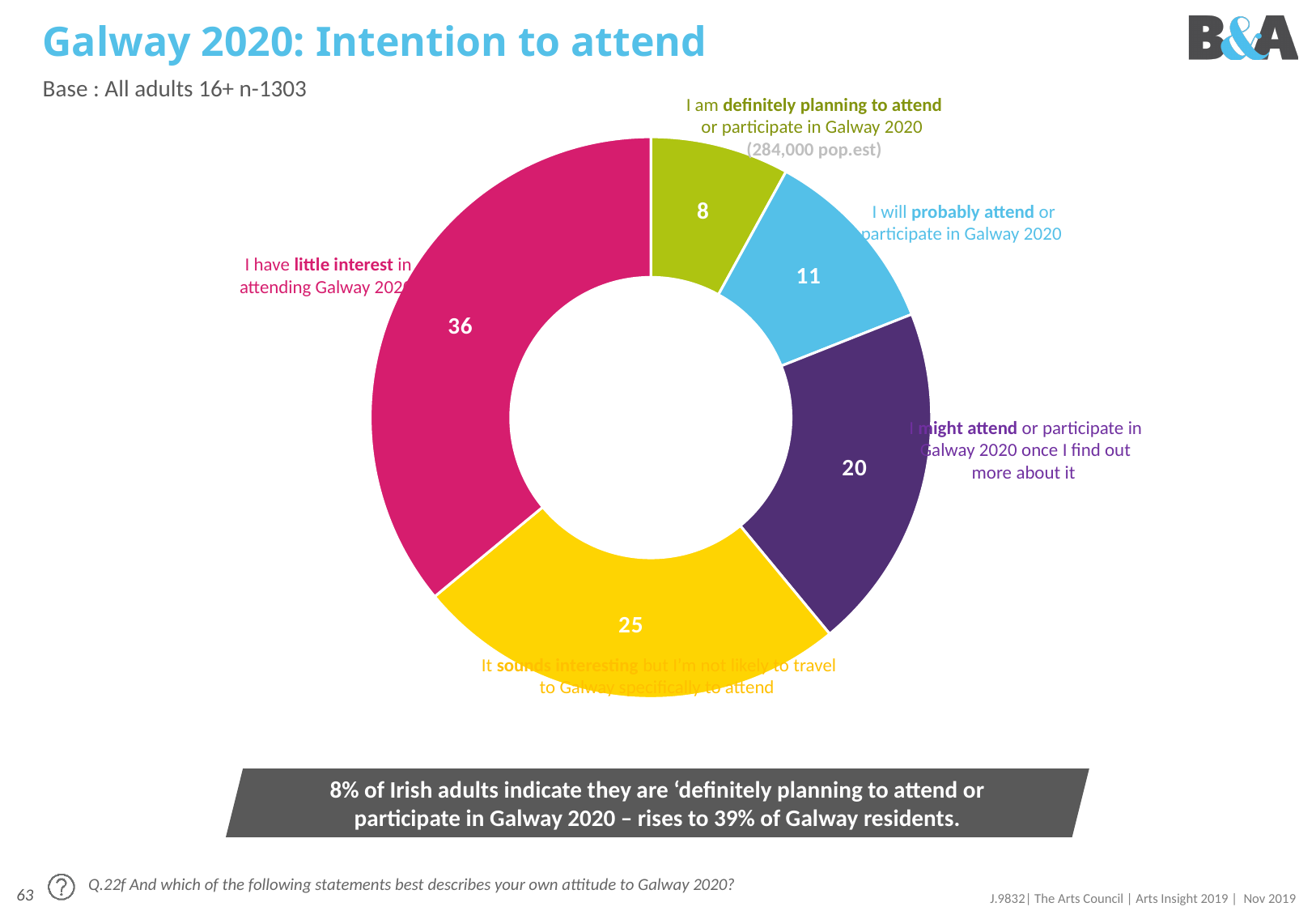
What value is shown for the segment 'It sounds interesting but I'm not likely to travel to Galway specifically to attend'? 25 Which segment of the chart has the largest value? I have little interest in attending Galway 2020 What value is shown for the segment 'I am definitely planning to attend or participate in Galway 2020'? 8 What value is shown for the segment 'I might attend or participate in Galway 2020 once I find out more about it'? 20 How many segments does the chart have? 5 What is the difference between the 'little interest' segment and the 'sounds interesting but not likely to travel' segment? 11 Which segment of the chart has the smallest value? I am definitely planning to attend or participate in Galway 2020 What value is shown for the segment 'I will probably attend or participate in Galway 2020'? 11 What is the combined value of the 'definitely planning to attend' and 'probably attend' segments? 19 What is the title of the slide's chart? Galway 2020: Intention to attend Which is larger: the 'might attend' segment or the 'probably attend' segment? I might attend or participate in Galway 2020 once I find out more about it What kind of chart is shown on the slide? Donut (pie) chart